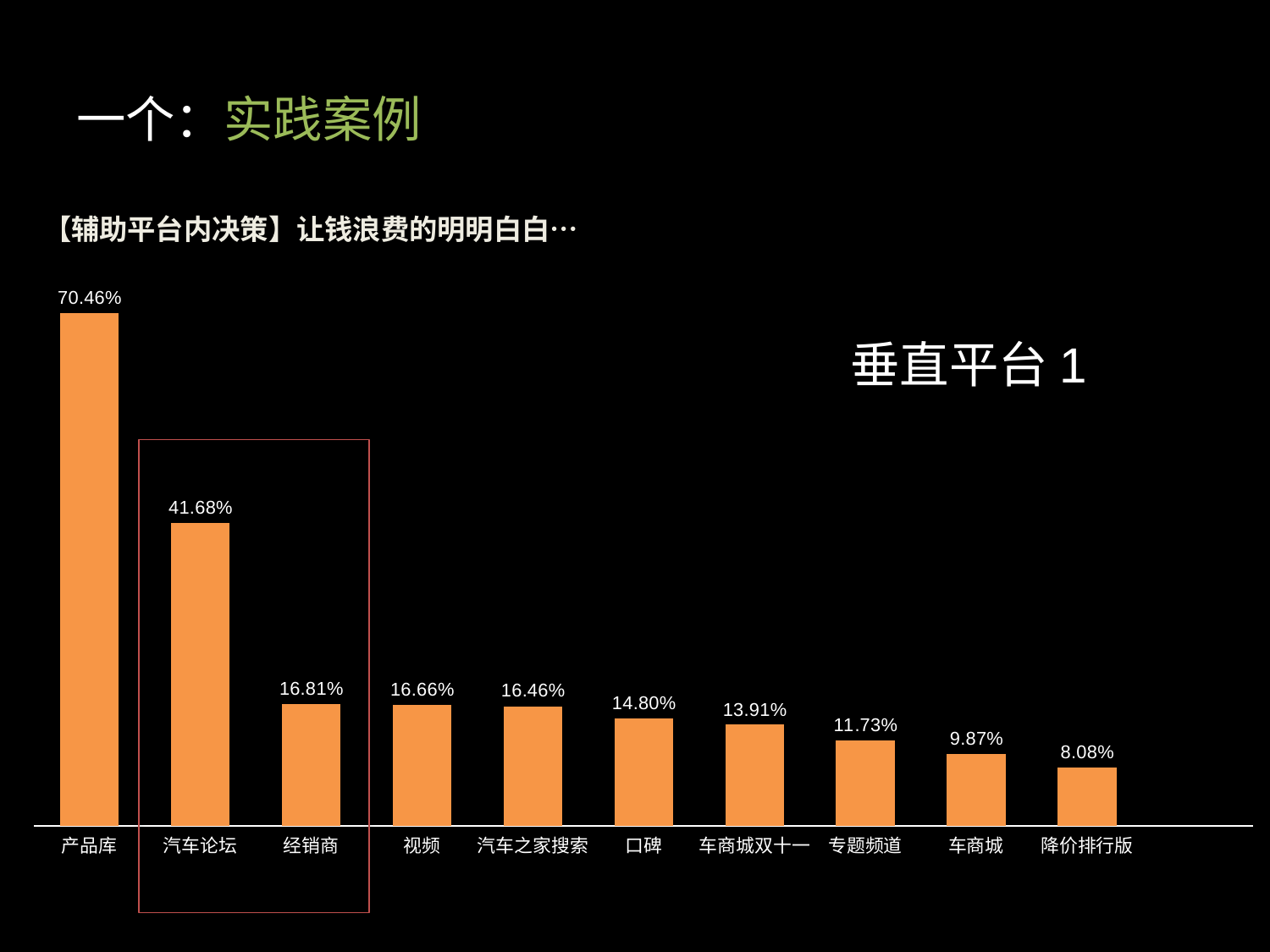
What is the difference between the values for 产品库 and 汽车论坛? 28.78% Do the values rise or fall from left to right along the x axis? Fall How many categories are shown on the x axis? 10 What is the value for 车商城双十一? 13.91% Which categories are enclosed by the red rectangle on the chart? 汽车论坛 and 经销商 What is the value for 产品库? 70.46% Which category has the lowest value? 降价排行版 What is the value for 降价排行版? 8.08% Which is larger, the value for 口碑 or the value for 专题频道? 口碑 What kind of chart is shown on the slide? Bar chart Which category has the highest value? 产品库 What is the value for 汽车论坛? 41.68%